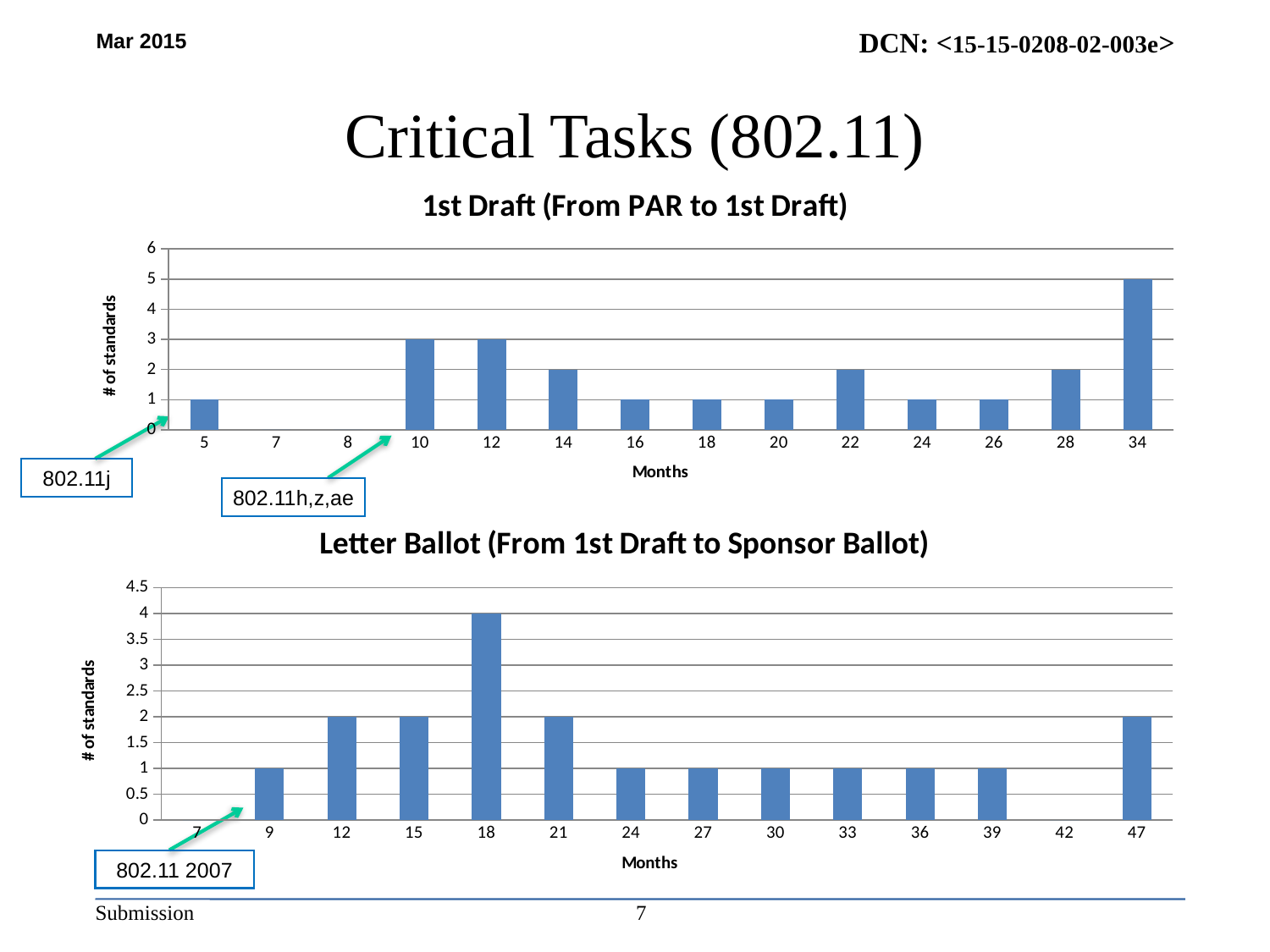
In the 'Letter Ballot (From 1st Draft to Sponsor Ballot)' chart, what is the number of standards at 47 months? 2 In the '1st Draft (From PAR to 1st Draft)' chart, how many month categories are shown on the x axis? 14 In the 'Letter Ballot (From 1st Draft to Sponsor Ballot)' chart, which month value has the highest number of standards? 18 In the 'Letter Ballot (From 1st Draft to Sponsor Ballot)' chart, which has more standards, 12 months or 24 months? 12 months In the 'Letter Ballot (From 1st Draft to Sponsor Ballot)' chart, what is the number of standards at 18 months? 4 In the '1st Draft (From PAR to 1st Draft)' chart, what is the difference in number of standards between 34 months and 28 months? 3 In the 'Letter Ballot (From 1st Draft to Sponsor Ballot)' chart, is the value at 18 months greater or less than 3? greater What is the y-axis label of the '1st Draft (From PAR to 1st Draft)' chart? # of standards What kind of chart is the 'Letter Ballot (From 1st Draft to Sponsor Ballot)' chart? Bar chart In the '1st Draft (From PAR to 1st Draft)' chart, which month value has the highest number of standards? 34 In the '1st Draft (From PAR to 1st Draft)' chart, what is the number of standards at 34 months? 5 In the '1st Draft (From PAR to 1st Draft)' chart, what is the number of standards at 10 months? 3